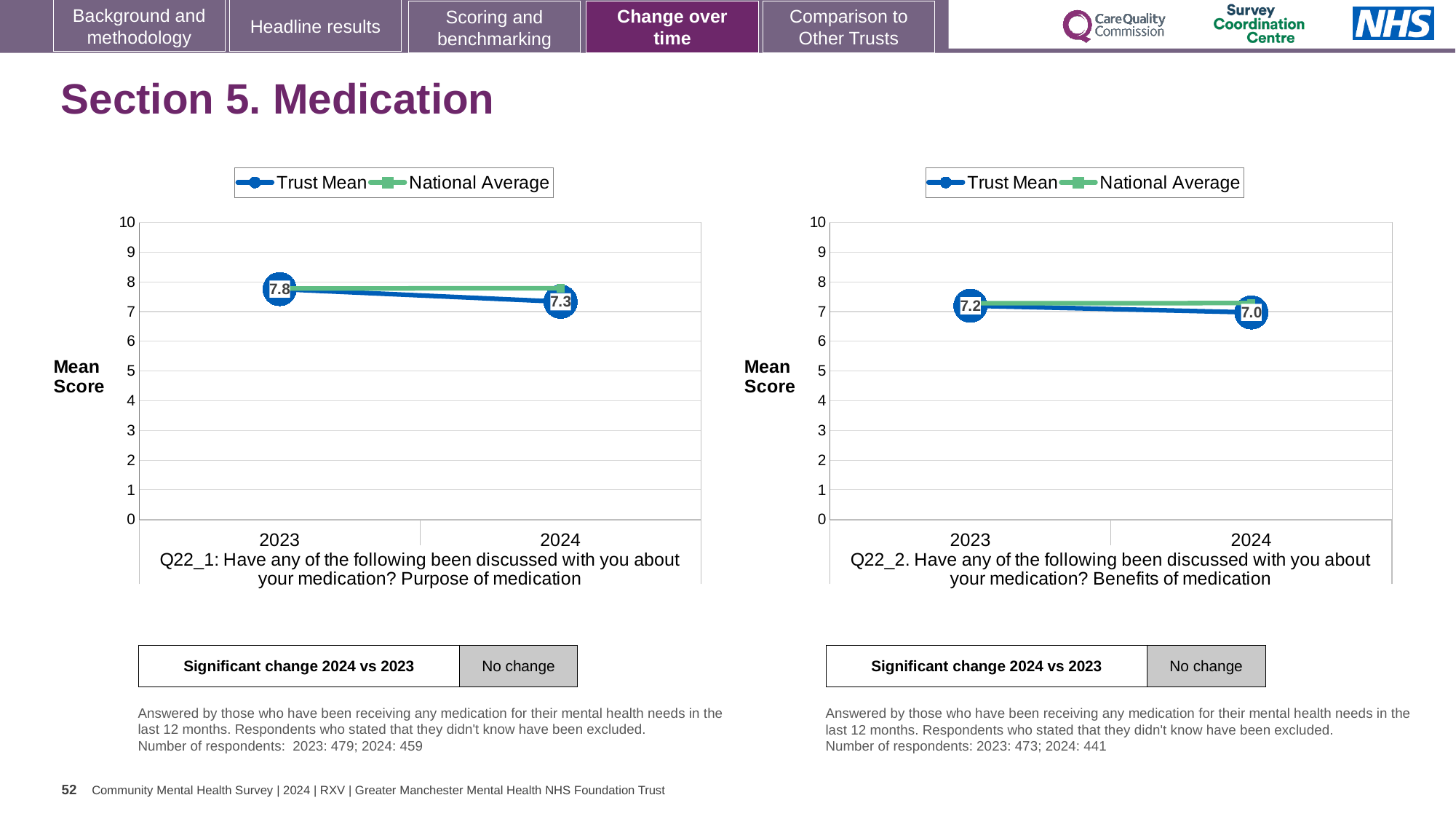
In the left chart (Q22_1), does the Trust Mean rise or fall from 2023 to 2024? fall In the left chart (Q22_1: Purpose of medication), what is the Trust Mean for 2023? 7.8 In the left chart (Q22_1: Purpose of medication), what is the Trust Mean for 2024? 7.3 How many years are shown on the x axis of the left chart (Q22_1)? 2 In the right chart (Q22_2), what is the difference between the Trust Mean for 2023 and 2024? 0.2 In the right chart (Q22_2: Benefits of medication), what is the Trust Mean for 2024? 7.0 In the right chart (Q22_2: Benefits of medication), what is the Trust Mean for 2023? 7.2 In the left chart (Q22_1), by how much did the Trust Mean change from 2023 to 2024? 0.5 How many series does the legend of the right chart (Q22_2) list? 2 In the left chart (Q22_1), which year has the higher Trust Mean, 2023 or 2024? 2023 What type of chart is used on the left for Q22_1? line chart In the right chart (Q22_2), is the Trust Mean for 2024 greater or less than 8? less